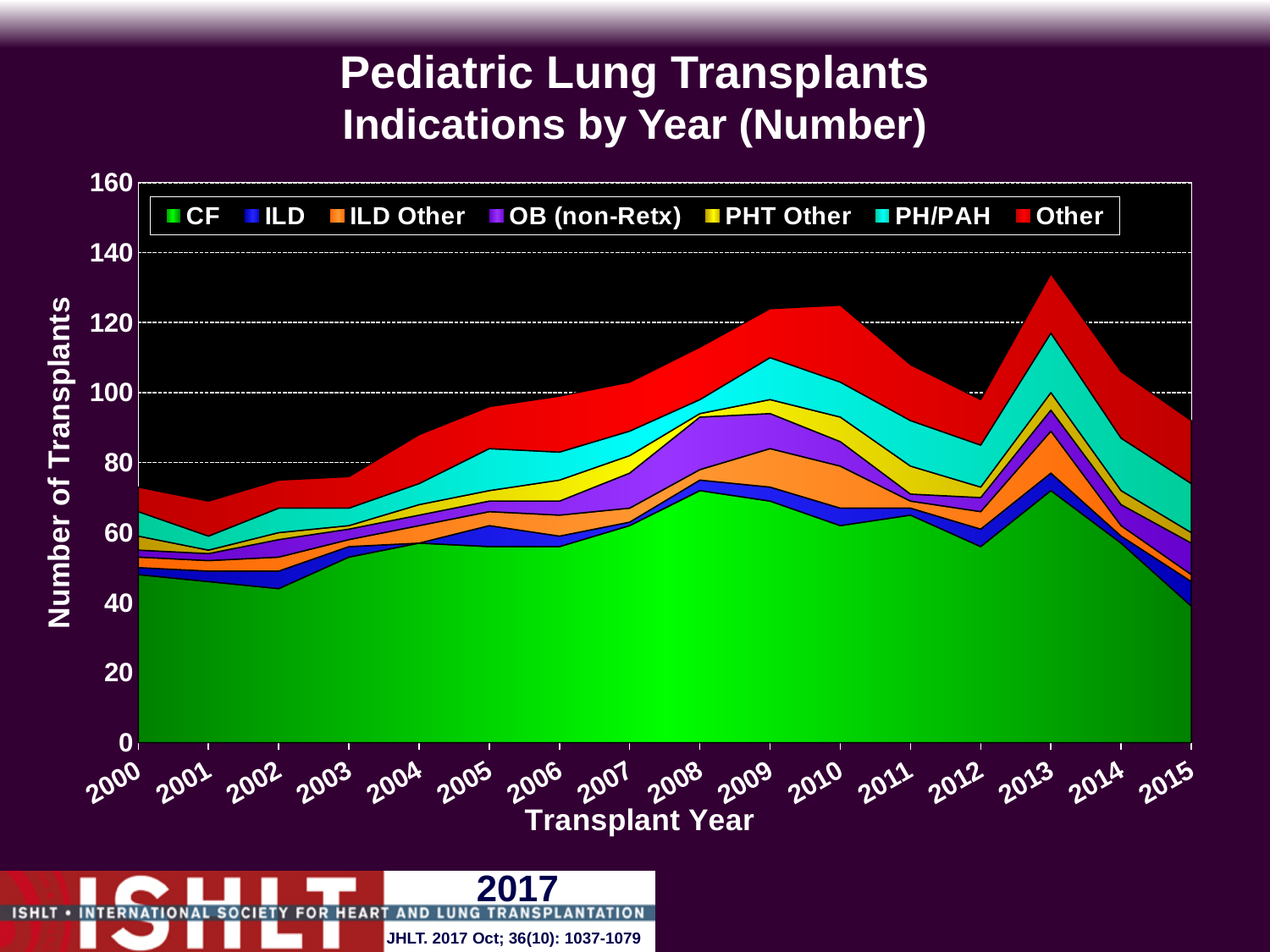
How many transplant years are plotted along the x axis? 16 Is the number of CF transplants in 2008 greater or less than 60? greater In which year is the total number of transplants highest? 2013 What kind of chart is shown on the slide? stacked area chart Is the total number of transplants in 2013 greater or less than 120? greater What is the label of the y axis? Number of Transplants Which year has a larger total number of transplants, 2013 or 2015? 2013 Is the total number of transplants in 2012 greater or less than 100? less What is the title of the chart? Pediatric Lung Transplants Indications by Year (Number) Does the total number of transplants rise or fall from 2003 to 2009? rise How many series does the legend list? 7